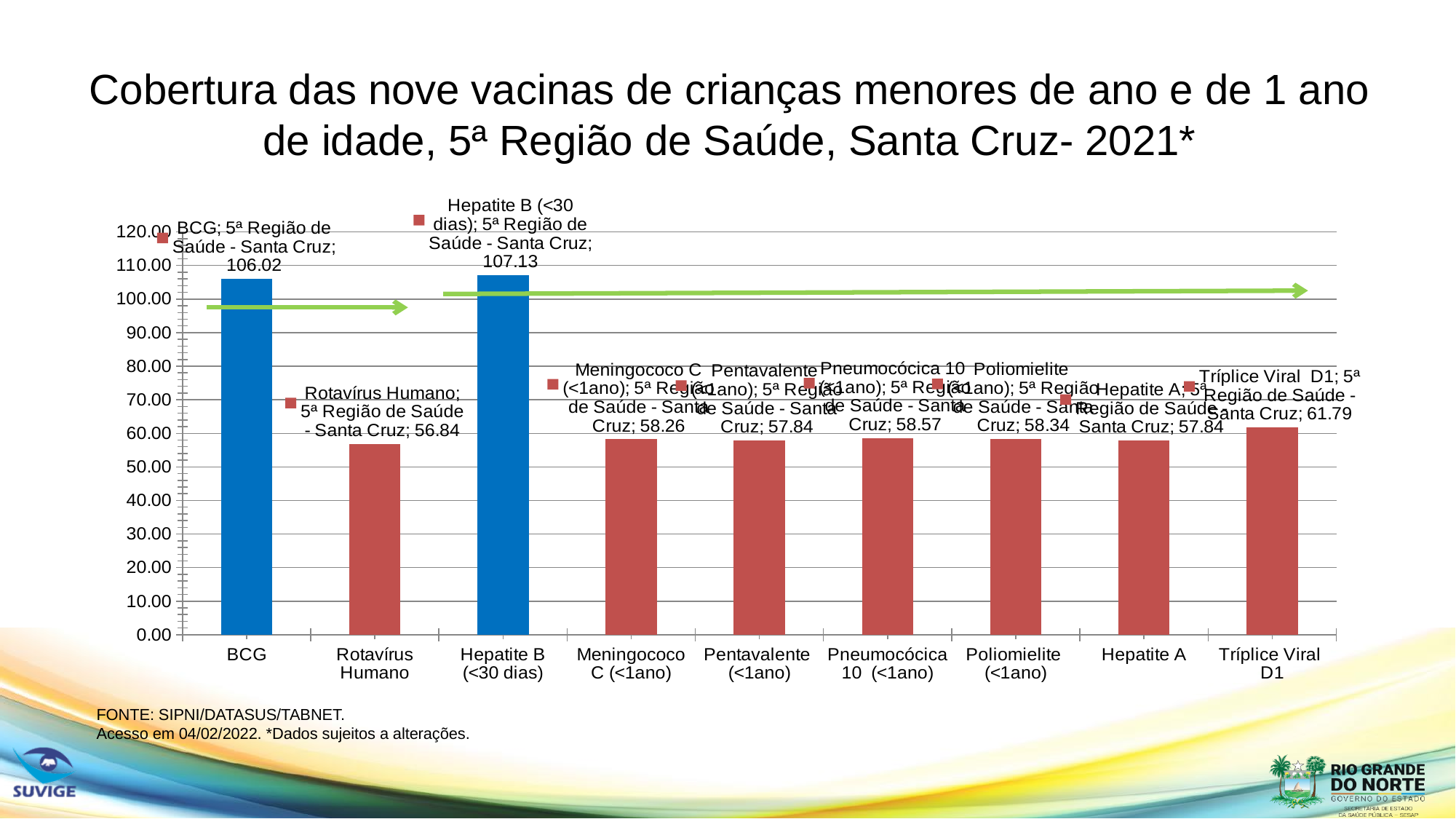
What kind of chart is shown on the slide? bar chart What is the difference between the values for Hepatite B (<30 dias) and BCG? 1.11 How many vaccine categories are shown on the x axis? 9 What is the value for Rotavírus Humano? 56.84 Is the value for Poliomielite (<1ano) greater or less than 60.00? less Which vaccine has the lowest coverage value? Rotavírus Humano What is the value for Tríplice Viral D1? 61.79 What is the value for Hepatite B (<30 dias)? 107.13 Which vaccine has the highest coverage value? Hepatite B (<30 dias) What is the data source cited below the chart? SIPNI/DATASUS/TABNET Which is larger, the value for Tríplice Viral D1 or the value for Pneumocócica 10 (<1ano)? Tríplice Viral D1 What is the value for BCG? 106.02